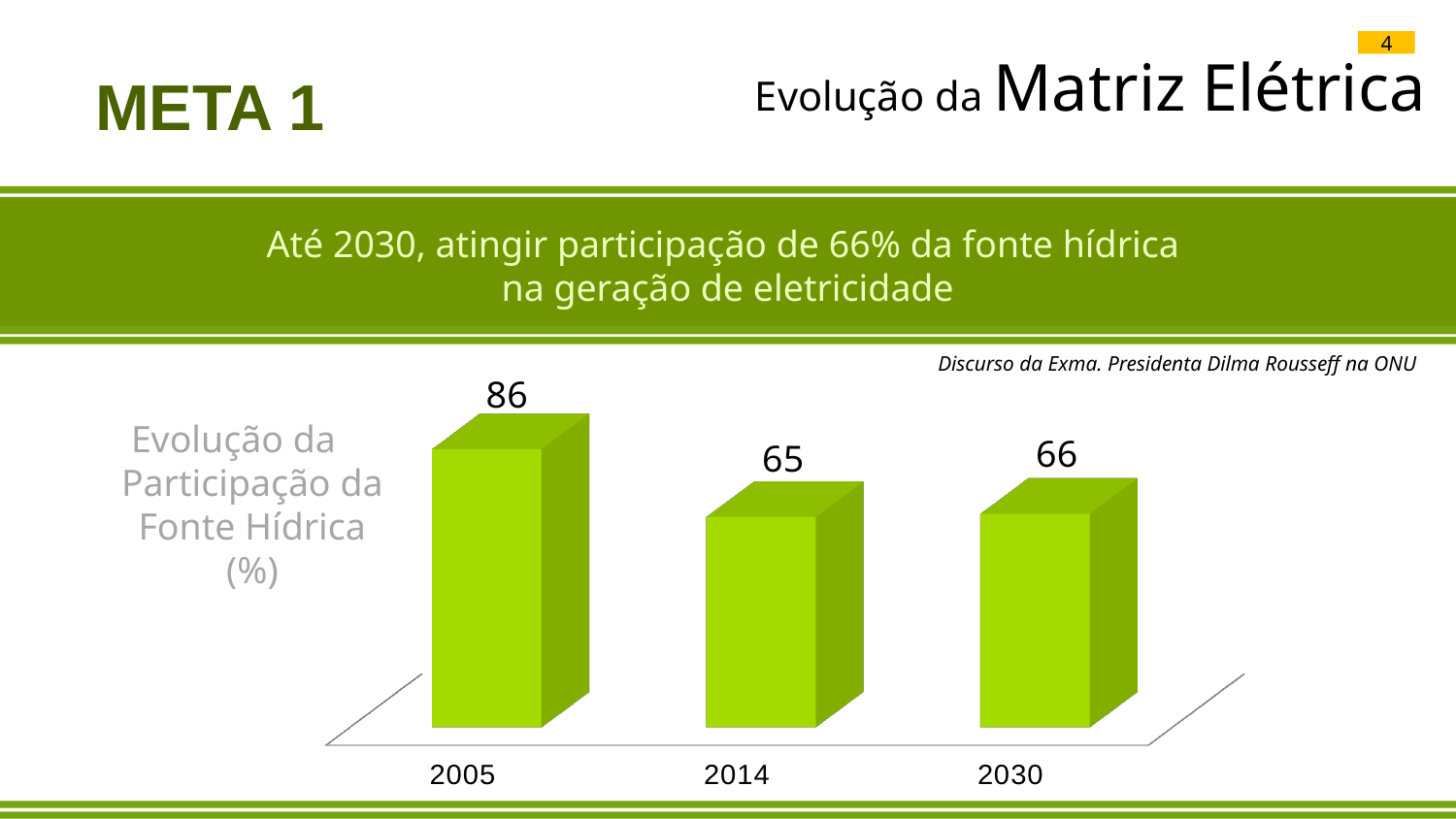
How many years are shown on the chart? 3 What is the value for 2005? 86 What is the difference between the values for 2005 and 2014? 21 What kind of chart is shown? bar chart Which is larger, the value for 2005 or the value for 2030? 2005 Which year has the highest value? 2005 Which year has the lowest value? 2014 Does the value fall or rise from 2005 to 2014? fall What is the difference between the values for 2005 and 2030? 20 What is the value for 2014? 65 What is the title of the chart? Evolução da Participação da Fonte Hídrica (%) What is the value for 2030? 66